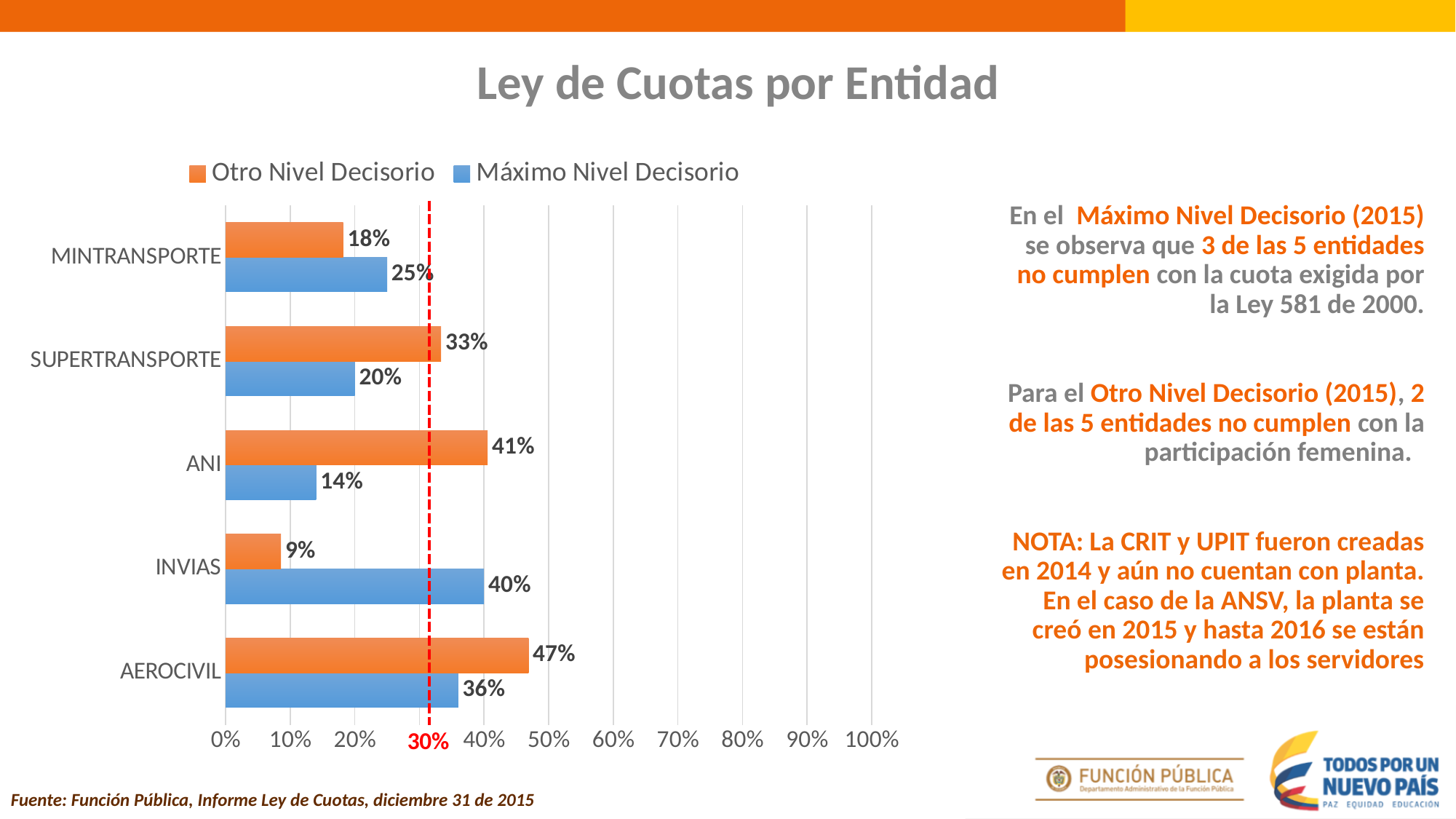
What is the difference between the Otro Nivel Decisorio and Máximo Nivel Decisorio values for AEROCIVIL? 11% What is the title of the chart? Ley de Cuotas por Entidad Which entity has the highest Otro Nivel Decisorio value? AEROCIVIL What kind of chart is shown on the slide? Bar chart How many entities are shown on the chart? 5 How many series does the legend list? 2 What is the Otro Nivel Decisorio value for ANI? 41% Which entity has the lowest Máximo Nivel Decisorio value? ANI What is the Máximo Nivel Decisorio value for INVIAS? 40% What is the Máximo Nivel Decisorio value for MINTRANSPORTE? 25% Is the Otro Nivel Decisorio value for INVIAS greater or less than 30%? less Which is larger for SUPERTRANSPORTE: Otro Nivel Decisorio or Máximo Nivel Decisorio? Otro Nivel Decisorio